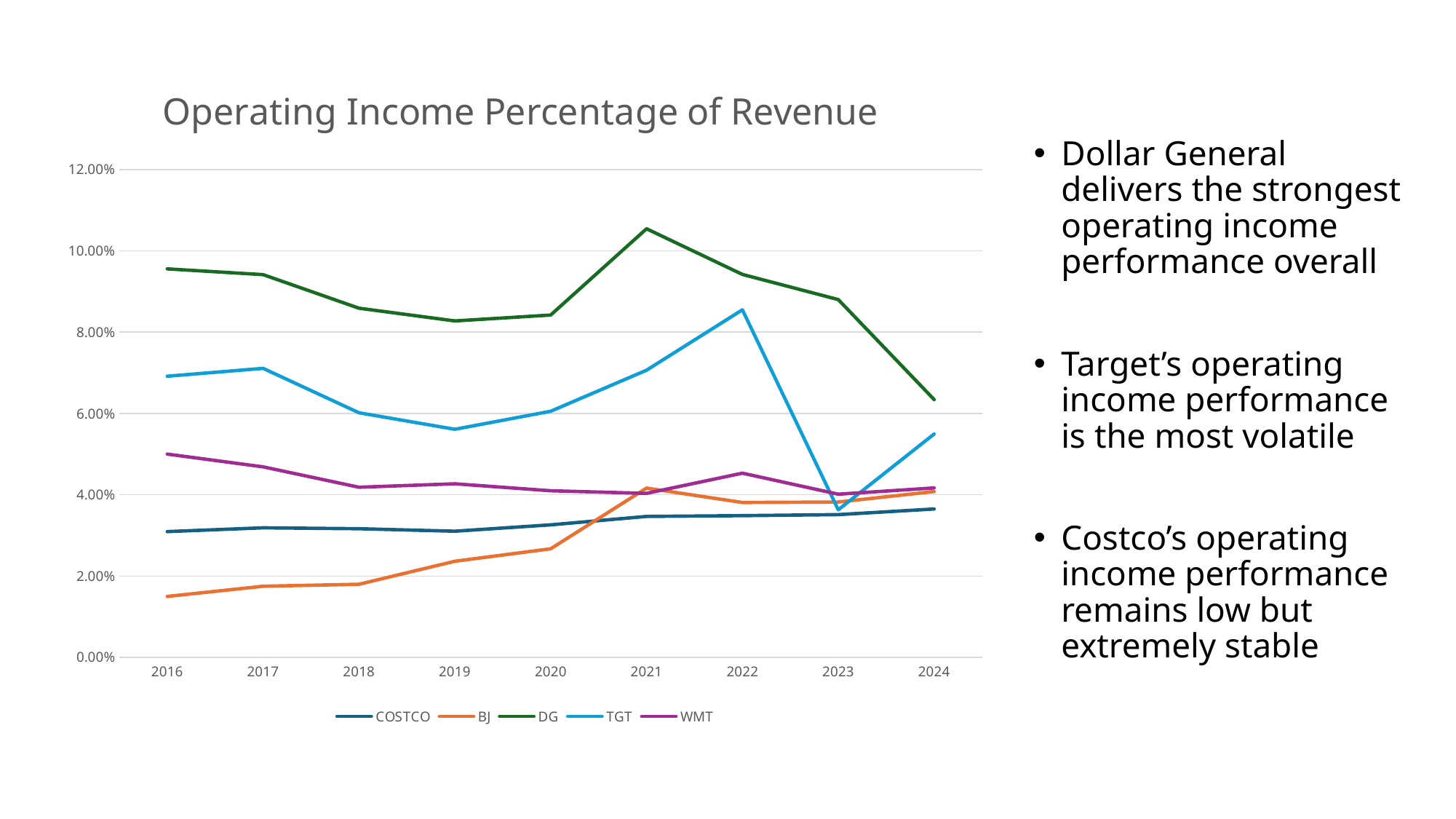
Which series has the highest operating income percentage in 2016? DG How many years are shown on the x axis? 9 How many series does the legend list? 5 In 2022, which is larger: the value for TGT or the value for WMT? TGT What is the title of the chart? Operating Income Percentage of Revenue Is the value for DG in 2021 greater or less than 10.00%? greater What kind of chart is shown on the slide? Line chart Is the value for BJ in 2016 greater or less than 2.00%? less Does the BJ line rise or fall from 2016 to 2021? Rise Which series has the lowest operating income percentage in 2016? BJ In which year does the DG line reach its highest point? 2021 Is the value for TGT in 2023 greater or less than 4.00%? less